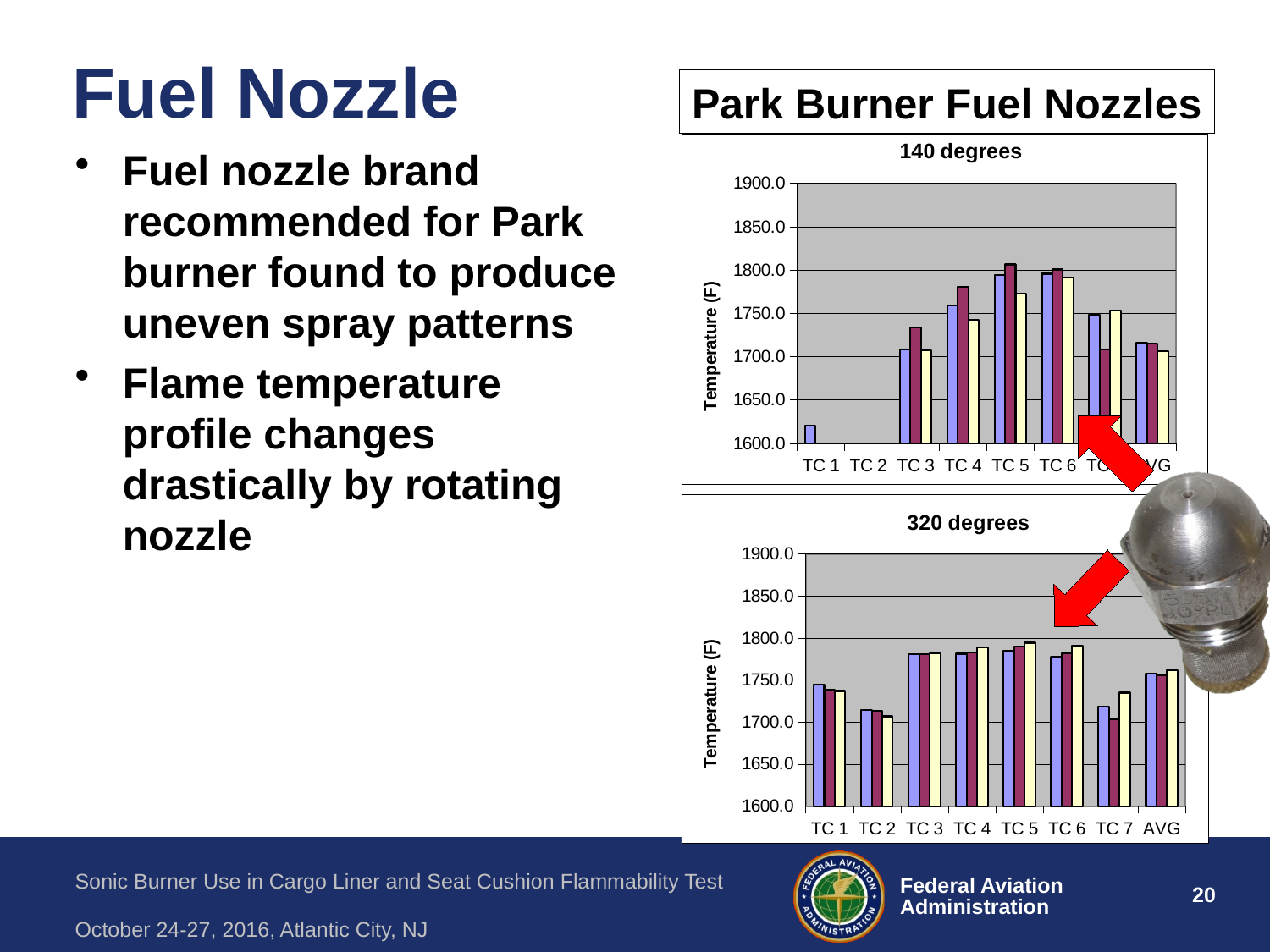
In the "140 degrees" chart, is the value of the first (blue) bar for TC 3 greater or less than 1700? greater In the "320 degrees" chart, which category has higher bars, TC 3 or TC 2? TC 3 How many categories are shown on the x axis of the "320 degrees" chart? 8 What is the title of the upper chart on the slide? 140 degrees In the "140 degrees" chart, is the value of the first (blue) bar for TC 1 greater or less than 1650? less In the "320 degrees" chart, are the bars for TC 3 greater or less than 1750? greater In the "320 degrees" chart, which category has the shortest bars? TC 2 In the "140 degrees" chart, which category has higher bars, TC 5 or TC 3? TC 5 What is the y-axis label of the "320 degrees" chart? Temperature (F) In the "140 degrees" chart, which category has the tallest bars? TC 5 What type of chart is the "140 degrees" chart? bar chart